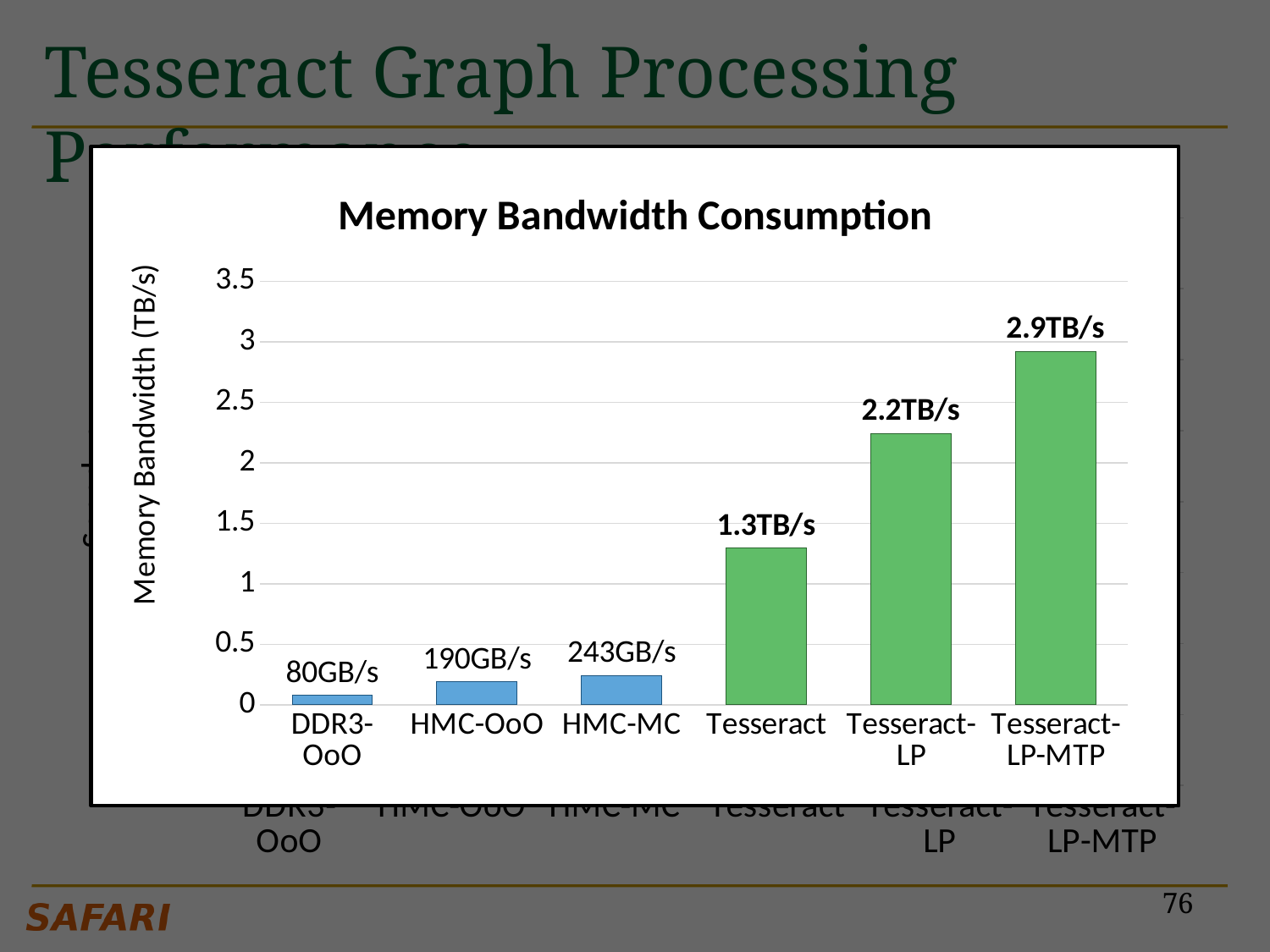
What is the memory bandwidth consumption for HMC-MC? 243GB/s What is the difference in memory bandwidth between HMC-MC and HMC-OoO? 53GB/s Which configuration has the highest memory bandwidth consumption? Tesseract-LP-MTP What kind of chart is shown on the slide? Bar chart What is the title of the chart? Memory Bandwidth Consumption Which configuration has the lowest memory bandwidth consumption? DDR3-OoO What is the difference in memory bandwidth between Tesseract-LP-MTP and Tesseract-LP? 0.7TB/s Which has higher memory bandwidth consumption, HMC-OoO or Tesseract? Tesseract What is the memory bandwidth consumption for DDR3-OoO? 80GB/s Is the value for Tesseract-LP greater or less than 2 TB/s? greater What is the memory bandwidth consumption for Tesseract-LP-MTP? 2.9TB/s How many configurations are shown on the x axis of the chart? 6